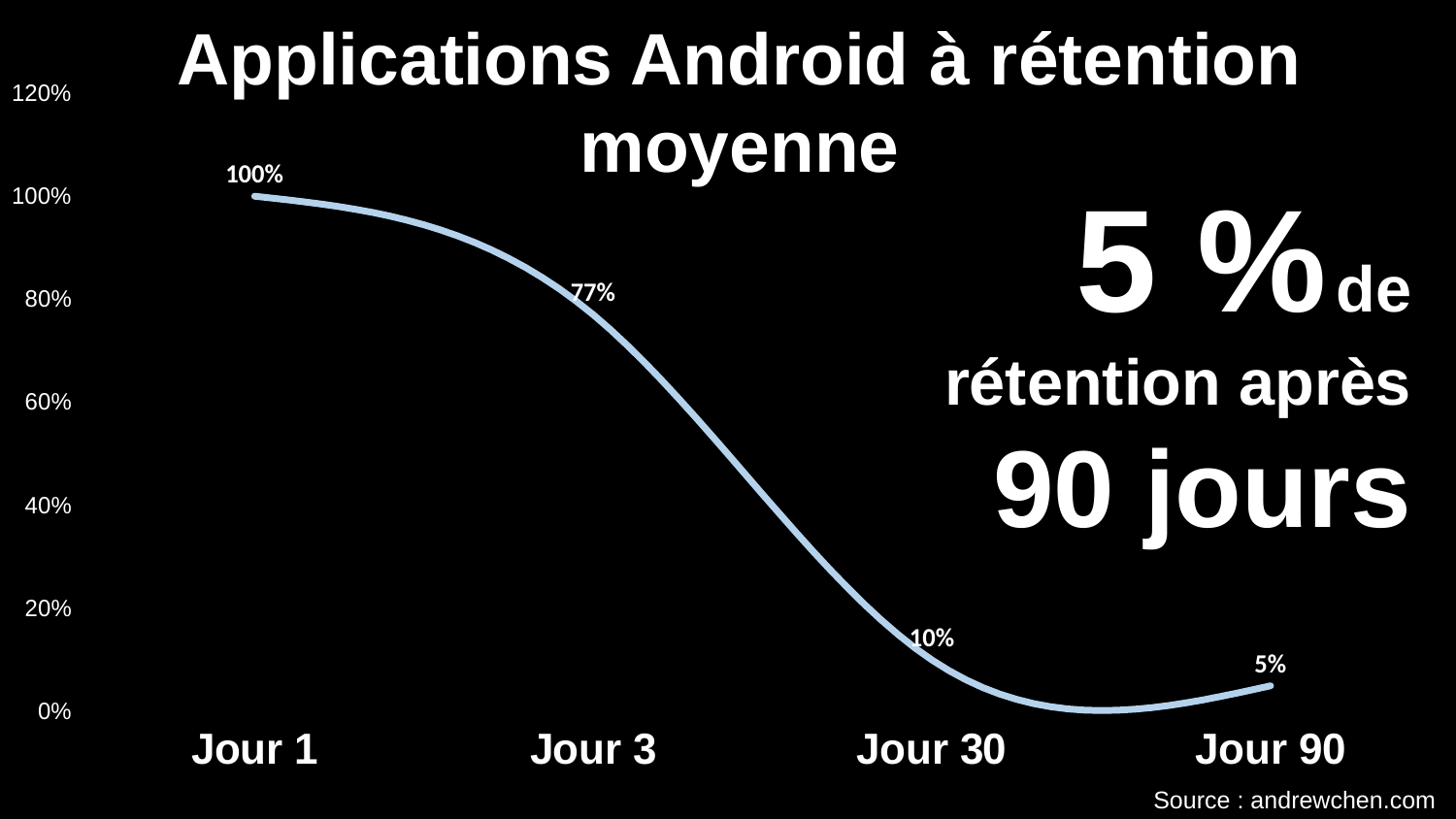
Do the values rise or fall from Jour 1 to Jour 90? Fall Which point on the x axis has the highest retention value? Jour 1 What is the difference between the retention at Jour 30 and at Jour 90? 5% What kind of chart is shown on the slide? Line chart Which point on the x axis has the lowest retention value? Jour 90 What is the retention value at Jour 90? 5% What is the difference between the retention at Jour 1 and at Jour 3? 23% How many data points are plotted on the chart? 4 Which is larger, the retention at Jour 3 or at Jour 30? Jour 3 What is the retention value at Jour 1? 100% What is the retention value at Jour 3? 77% What is the retention value at Jour 30? 10%